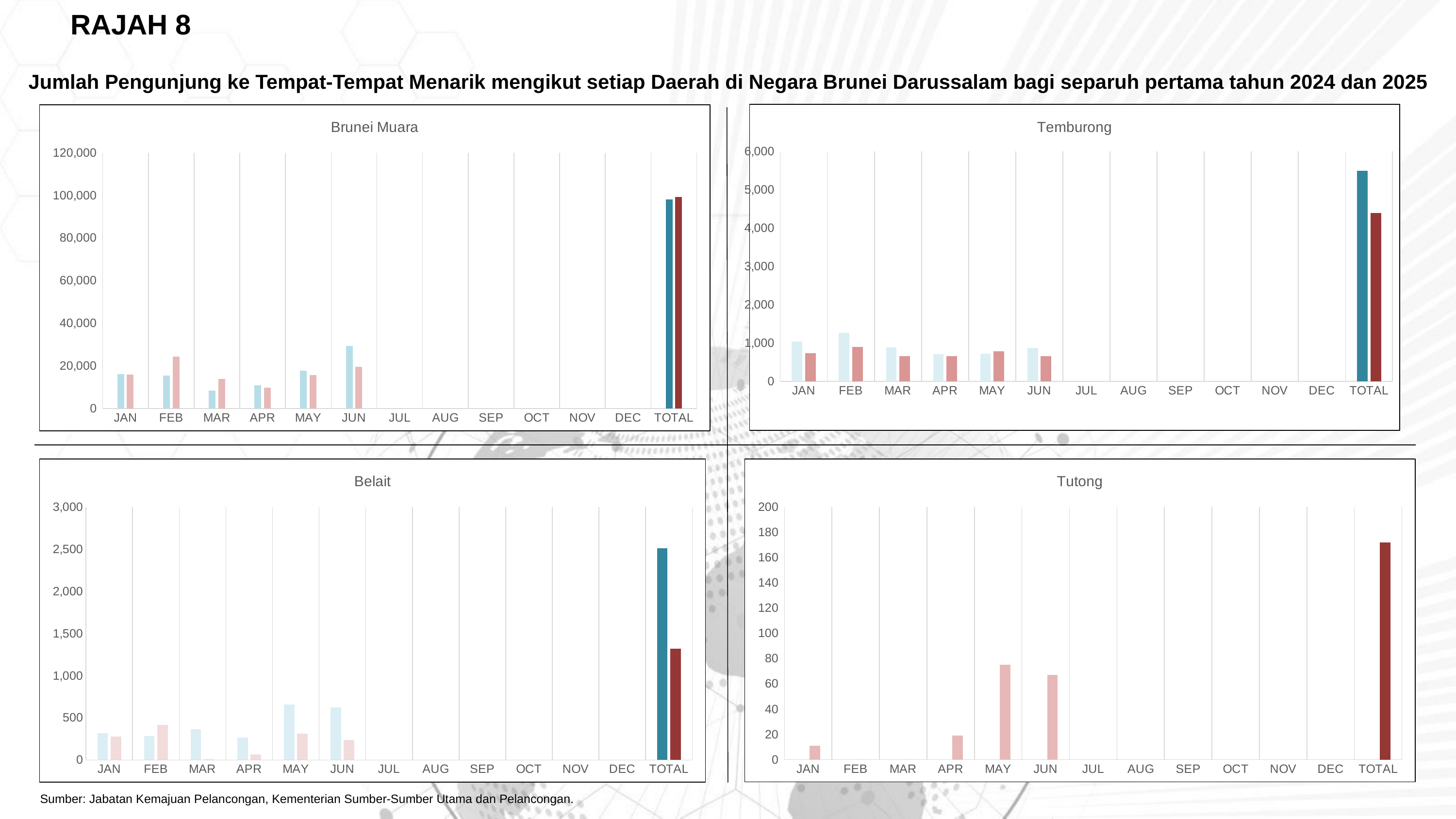
In the Brunei Muara chart, which month from JAN to JUN has the tallest blue bar? JUN In the Brunei Muara chart, is the value of the dark blue TOTAL bar greater or less than 80,000? greater In the Tutong chart, how many months from JAN to DEC show a bar? 4 In the Brunei Muara chart, is the value of the blue bar for JUN greater or less than 20,000? greater In the Belait chart, is the value of the dark red TOTAL bar greater or less than 2,000? less In the Temburong chart, which month from JAN to JUN has the tallest blue bar? FEB What kind of chart is the Brunei Muara chart? bar chart How many categories are shown on the x axis of the Belait chart? 13 In the Belait chart, which TOTAL bar is larger, the dark blue one or the dark red one? the dark blue one